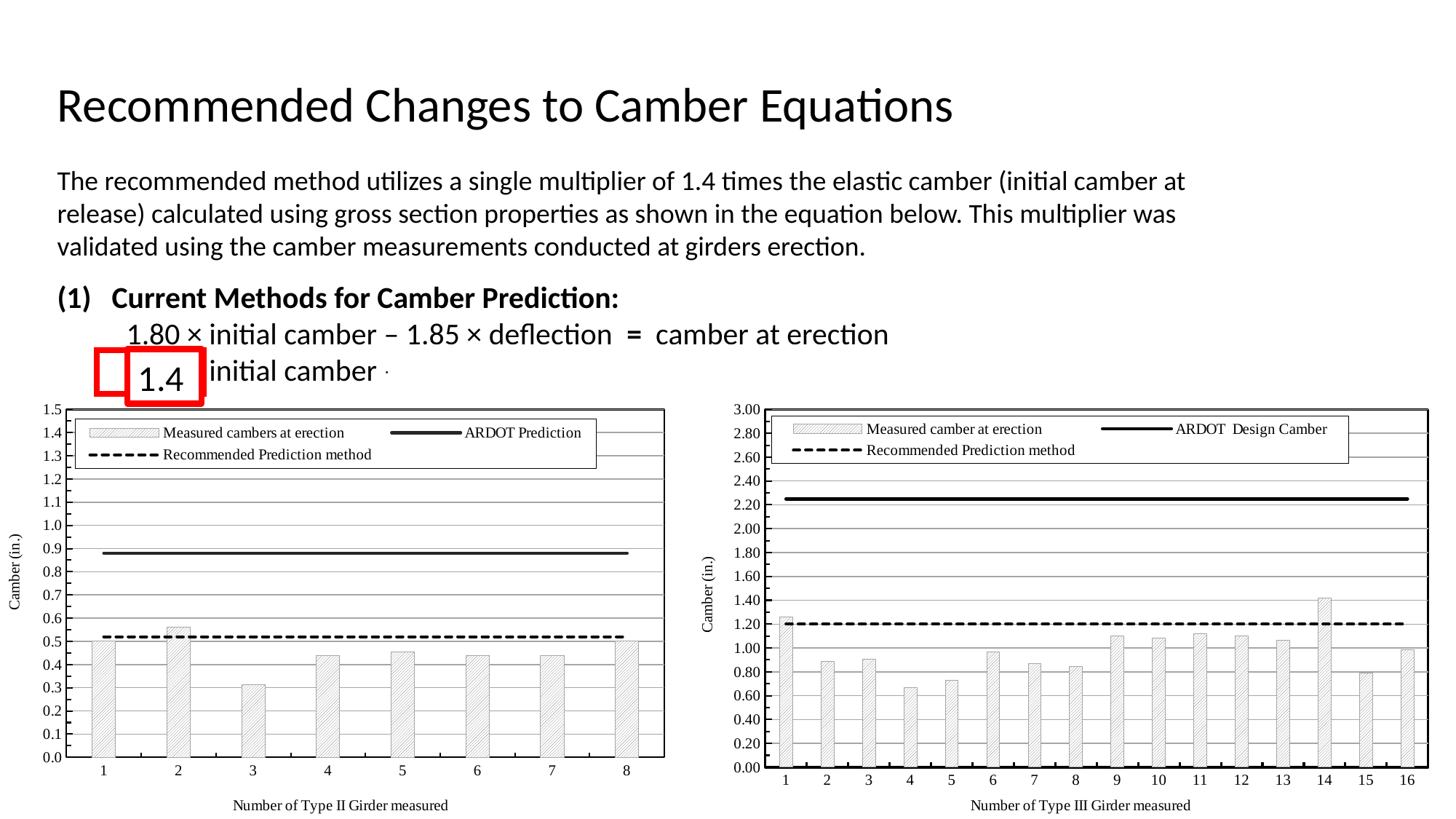
What kind of chart is used for the measured cambers in the left chart (Type II Girder)? bar chart In the right chart (Type III Girder), which has the larger measured camber: girder 14 or girder 4? girder 14 What is the y-axis title of the right chart (Type III Girder)? Camber (in.) In the left chart (Type II Girder), is the measured camber for girder 3 greater or less than 0.4? less In the left chart (Type II Girder), how many entries does the legend list? 3 In the right chart (Type III Girder), which girder number has the highest measured camber at erection? 14 In the right chart (Type III Girder), is the measured camber for girder 14 greater or less than 1.20? greater In the right chart (Type III Girder), how many girders are plotted on the x axis? 16 In the left chart (Type II Girder), how many girders are plotted on the x axis? 8 In the right chart (Type III Girder), which girder number has the lowest measured camber at erection? 4 In the left chart (Type II Girder), which girder number has the highest measured camber at erection? 2 In the left chart (Type II Girder), which girder number has the lowest measured camber at erection? 3